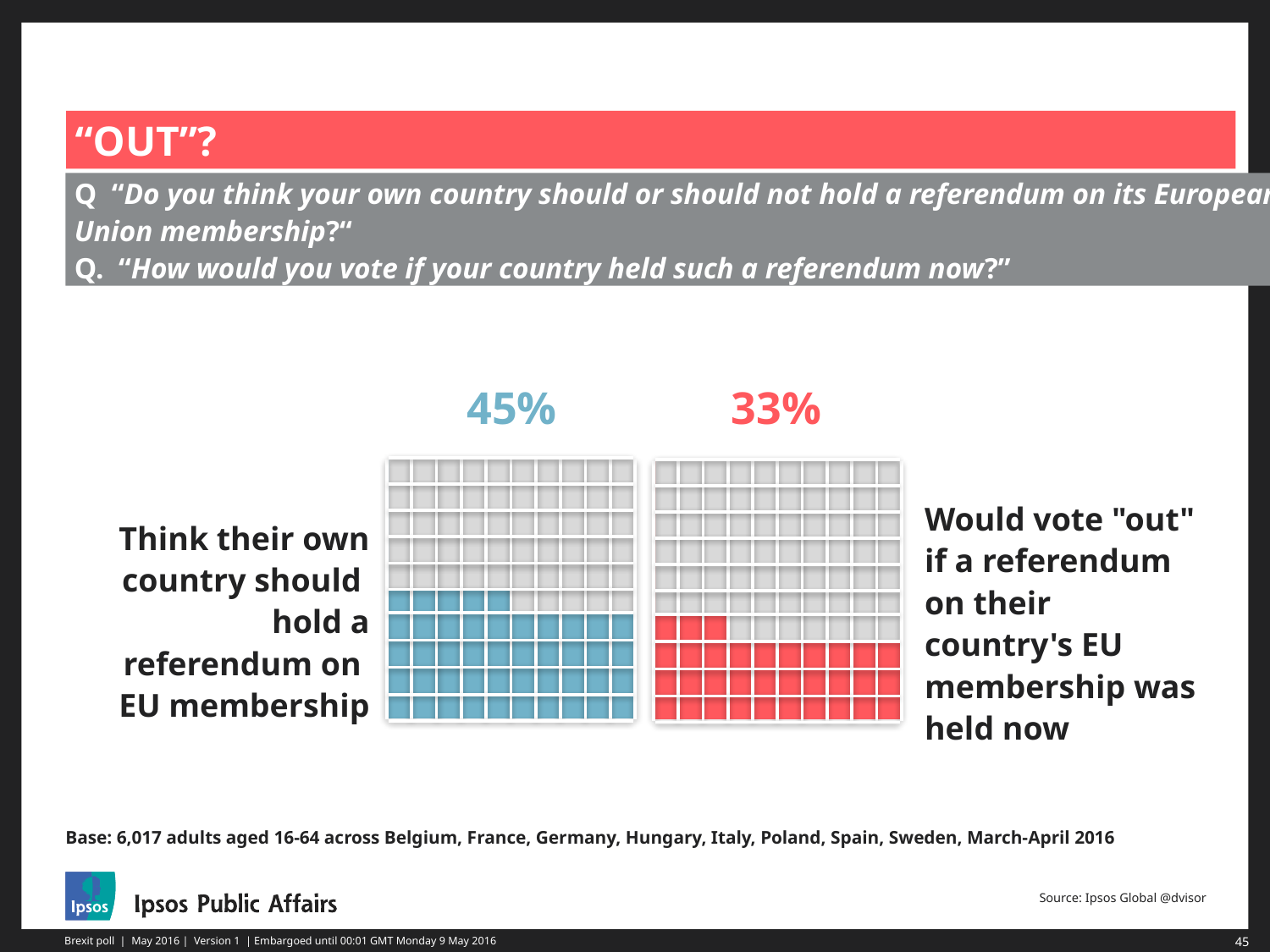
What is the difference in percentage points between the share who think their country should hold a referendum (45%) and the share who would vote "out" (33%)? 12 percentage points Is the share who would vote "out" greater or less than 50%? less Which of the two measures shown has the lowest value? Would vote "out" if a referendum was held now (33%) What percentage think their own country should hold a referendum on EU membership? 45% How many adults make up the base for the data shown? 6,017 What kind of chart is used to display the 45% and 33% figures? Waffle chart (grid of 100 squares) What colour are the filled squares in the chart showing 33%? Red What colour are the filled squares in the chart showing 45%? Blue What percentage would vote "out" if a referendum on their country's EU membership was held now? 33% Which of the two measures shown has the highest value? Think their own country should hold a referendum on EU membership (45%) How many percentage values are displayed on the slide's charts? 2 Which is higher: the share who think their country should hold a referendum, or the share who would vote "out"? Think their own country should hold a referendum (45%)